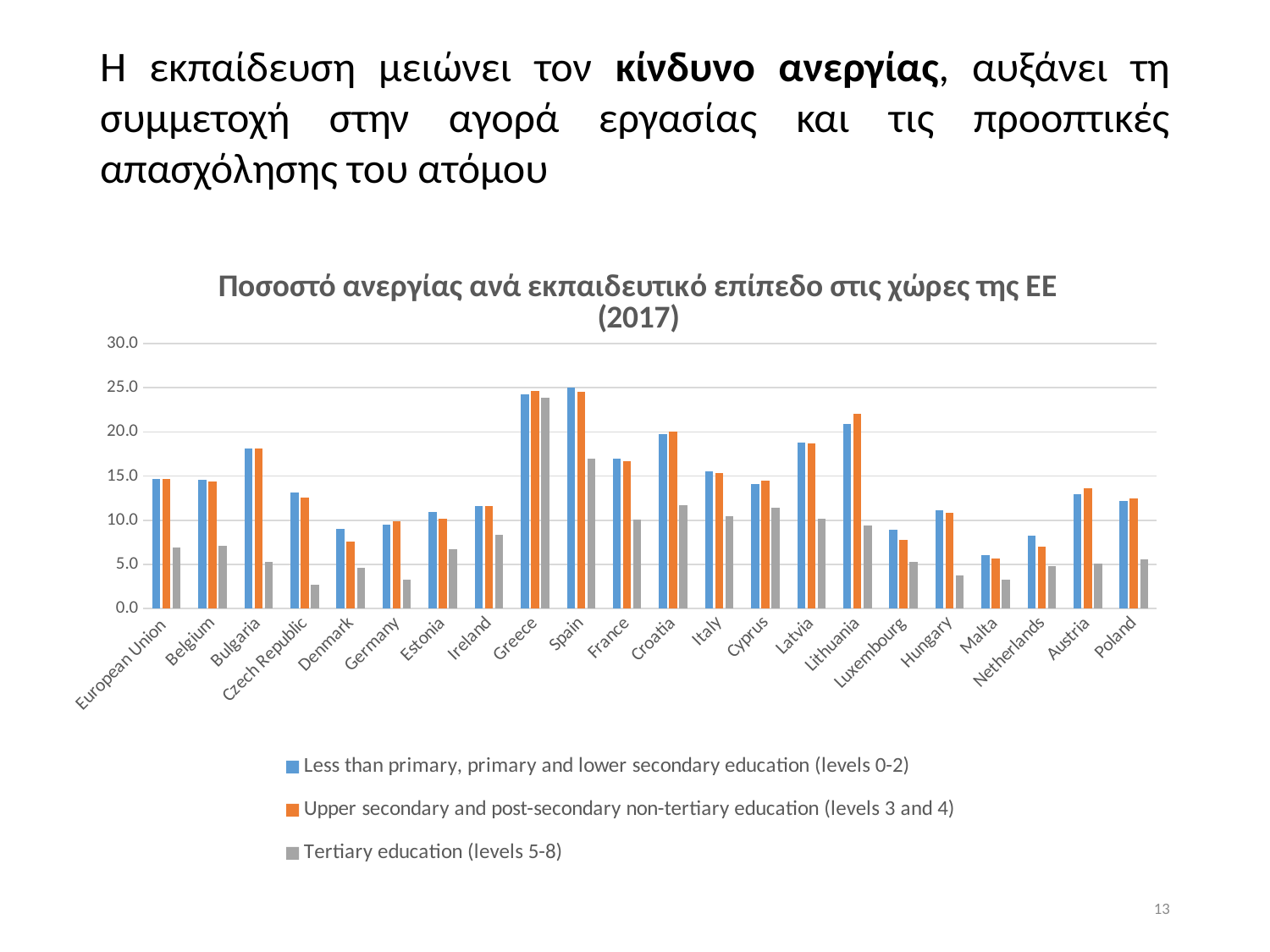
How many series does the legend list? 3 What kind of chart is shown on the slide? bar chart Which category has the highest value for Tertiary education (levels 5-8)? Greece Is the value for Greece in Tertiary education (levels 5-8) greater or less than 20.0? greater Is the value for Czech Republic in Tertiary education (levels 5-8) greater or less than 5.0? less How many countries/categories are shown on the x axis? 22 Which is larger for Tertiary education (levels 5-8): Spain or France? Spain Is the value for Lithuania in Upper secondary and post-secondary non-tertiary education (levels 3 and 4) greater or less than 20.0? greater Which is larger for Upper secondary and post-secondary non-tertiary education (levels 3 and 4): Lithuania or Latvia? Lithuania Which category has the lowest value for Less than primary, primary and lower secondary education (levels 0-2)? Malta What year is given in the chart title? 2017